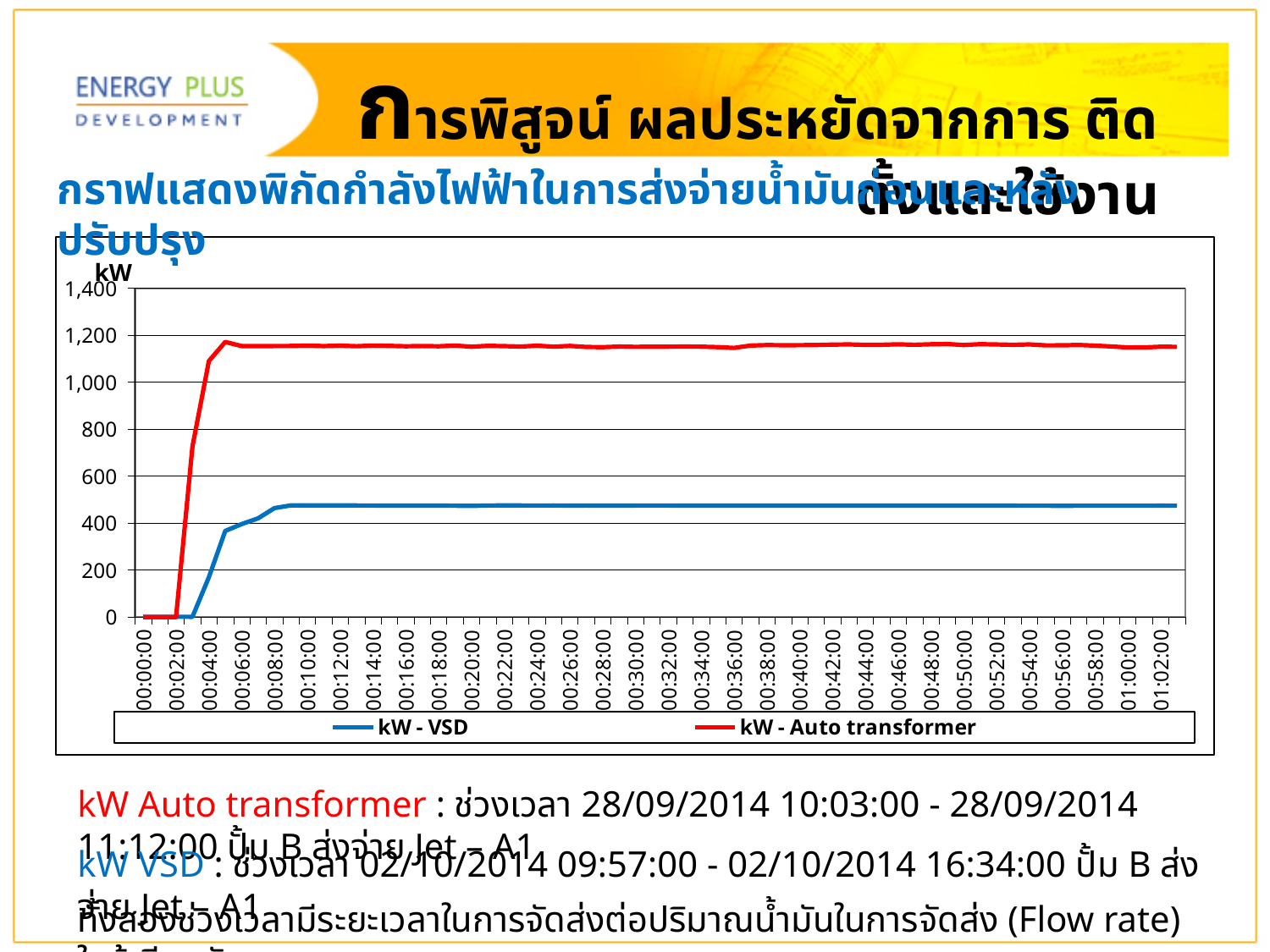
Does the kW - VSD line rise or fall between 00:02:00 and 00:08:00? rise What are the two series named in the chart legend? kW - VSD and kW - Auto transformer What kind of chart is shown on the slide? line chart How many series does the chart legend list? 2 Is the value of kW - VSD at 00:30:00 greater or less than 600? less How many time labels are shown along the x axis of the chart? 32 Is the value of kW - VSD at 00:40:00 greater or less than 400? greater Is the value of kW - Auto transformer at 00:02:00 greater or less than 200? less Which colour is used for the kW - Auto transformer line? red Which series reaches the highest values on the chart? kW - Auto transformer At 00:20:00, which series has the higher value, kW - VSD or kW - Auto transformer? kW - Auto transformer